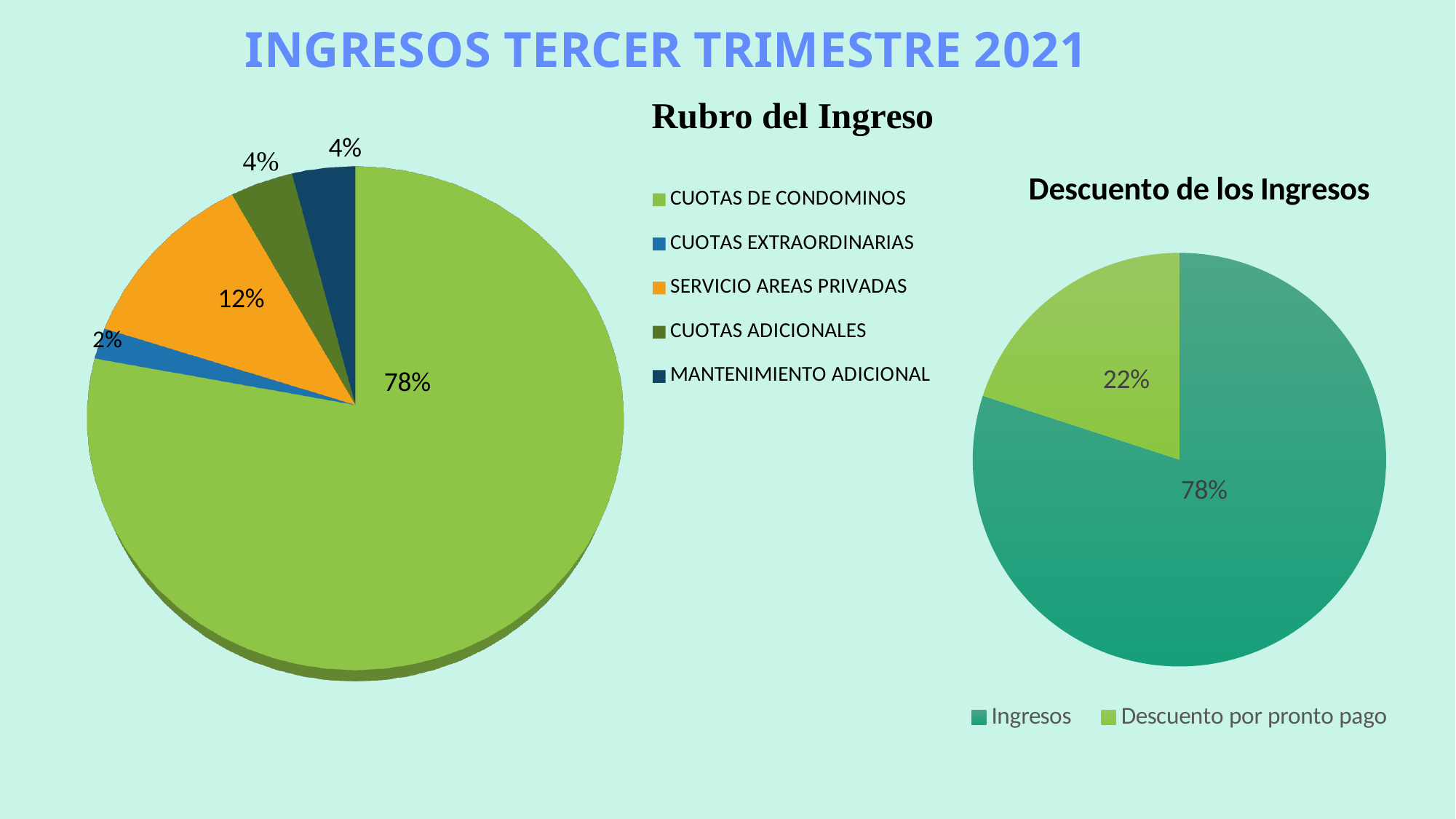
In the 'Rubro del Ingreso' chart, what is the difference between the shares of CUOTAS DE CONDOMINOS and SERVICIO AREAS PRIVADAS? 66% In the 'Rubro del Ingreso' chart, which category has the smallest slice? CUOTAS EXTRAORDINARIAS In the 'Rubro del Ingreso' chart, how many categories are shown? 5 In the 'Descuento de los Ingresos' chart, what share does Descuento por pronto pago have? 22% What type of chart is 'Descuento de los Ingresos'? Pie chart In the 'Rubro del Ingreso' chart, which category has the largest slice? CUOTAS DE CONDOMINOS In the 'Rubro del Ingreso' chart, what share does CUOTAS DE CONDOMINOS have? 78% In the 'Rubro del Ingreso' chart, what share does CUOTAS EXTRAORDINARIAS have? 2% In the 'Descuento de los Ingresos' chart, which is larger, Ingresos or Descuento por pronto pago? Ingresos